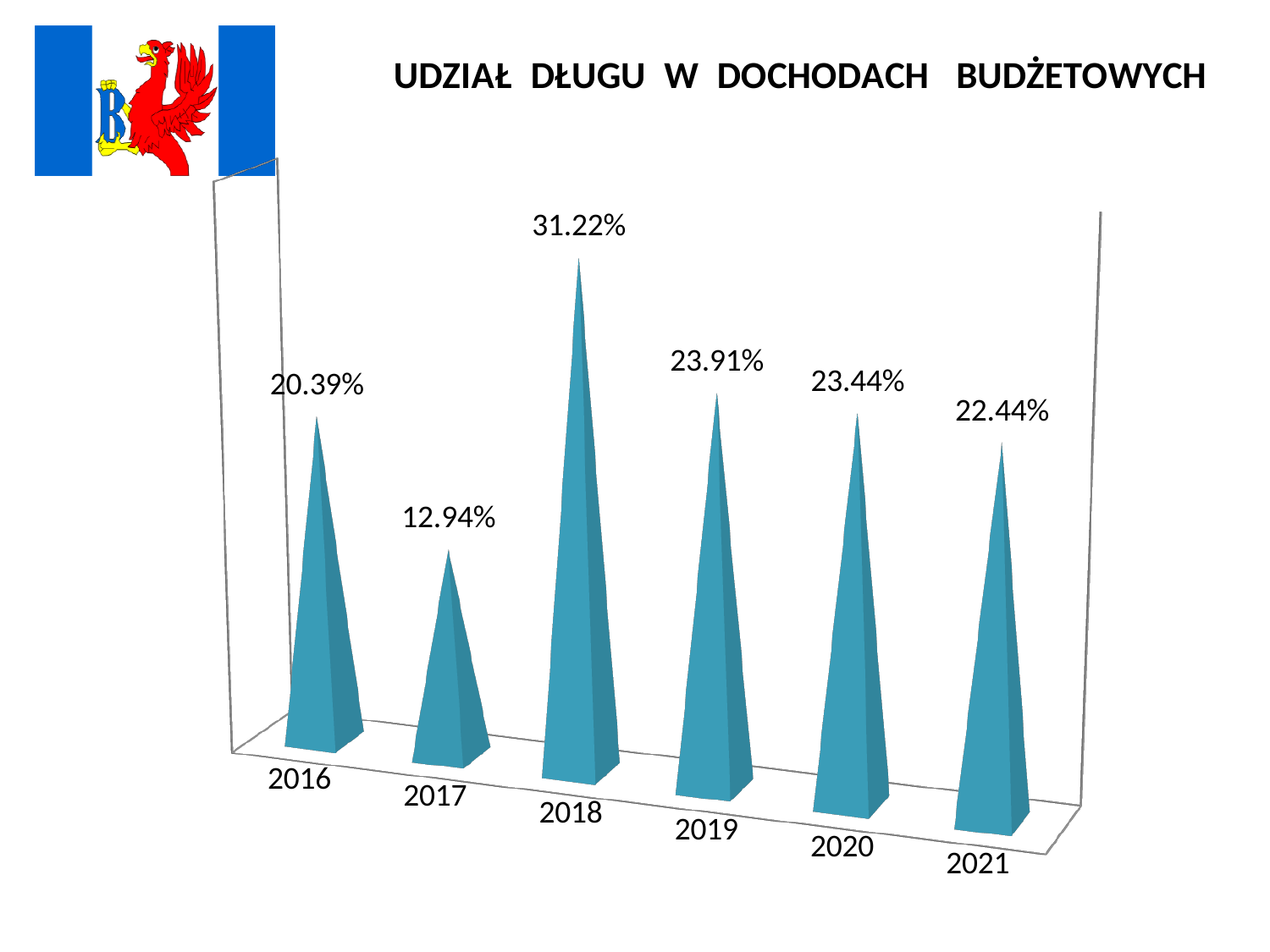
Which year has the lowest value? 2017 What kind of chart is this? bar chart What is the value for 2018? 31.22% What is the value for 2017? 12.94% Which is larger, the value for 2016 or the value for 2021? 2021 What is the difference between the values for 2019 and 2020? 0.47% Which year has the highest value? 2018 What is the value for 2021? 22.44% Does the value rise or fall from 2018 to 2021? fall What is the title of the chart? UDZIAŁ DŁUGU W DOCHODACH BUDŻETOWYCH What is the difference between the values for 2018 and 2017? 18.28% How many years are shown on the chart? 6